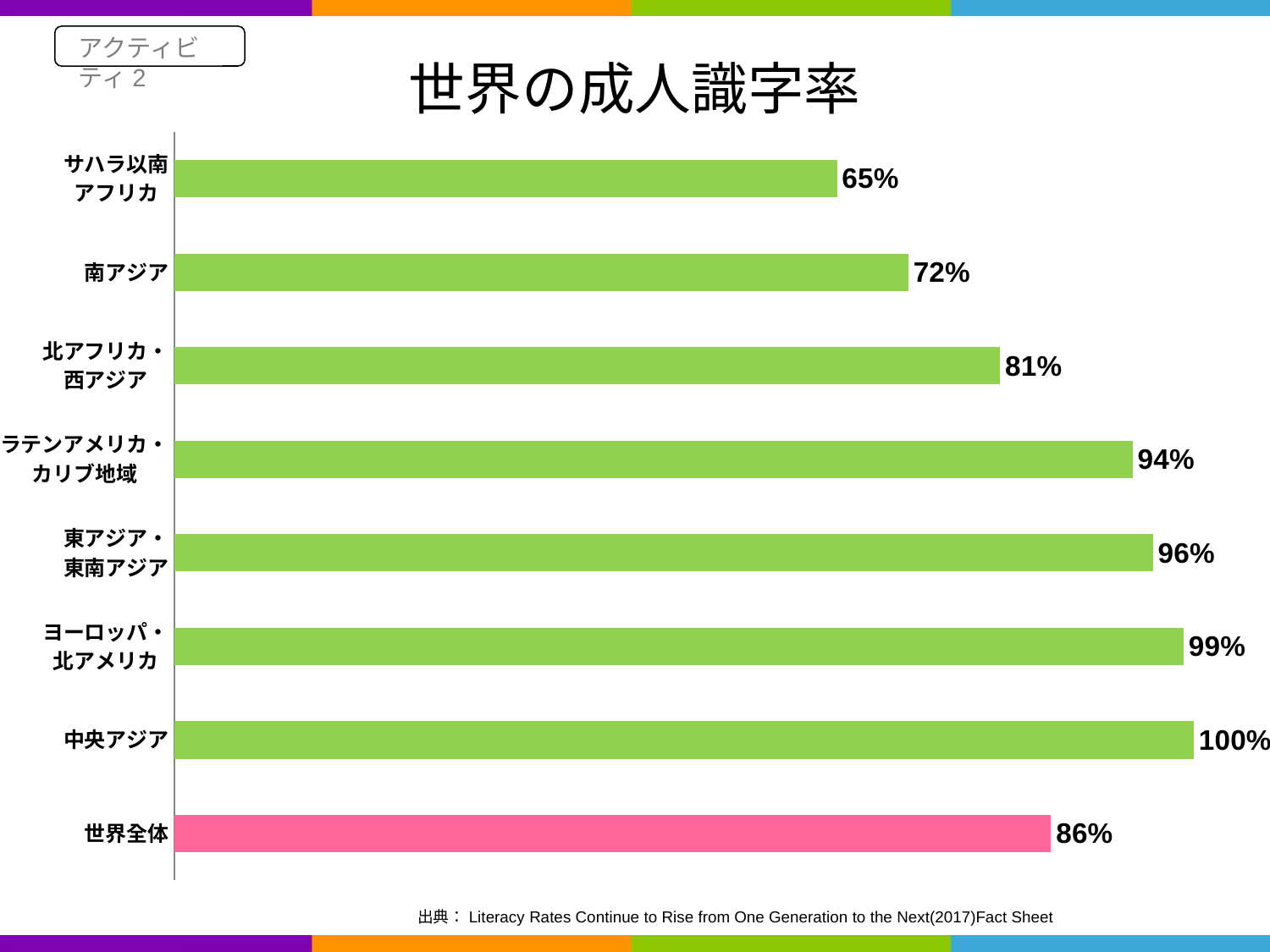
What is the value shown for ラテンアメリカ・カリブ地域? 94% What is the value shown for 世界全体? 86% What kind of chart is shown on the slide? Bar chart What is the title of the chart? 世界の成人識字率 How many bars are shown on the chart? 8 What is the difference between the values for ヨーロッパ・北アメリカ and 南アジア? 27% What is the adult literacy rate shown for サハラ以南アフリカ? 65% Which region has the lowest adult literacy rate on the chart? サハラ以南アフリカ What is the difference between the values for 世界全体 and 北アフリカ・西アジア? 5% Which bar is coloured pink instead of green? 世界全体 Which region has the highest adult literacy rate on the chart? 中央アジア Which is larger, the value for 東アジア・東南アジア or the value for ラテンアメリカ・カリブ地域? 東アジア・東南アジア